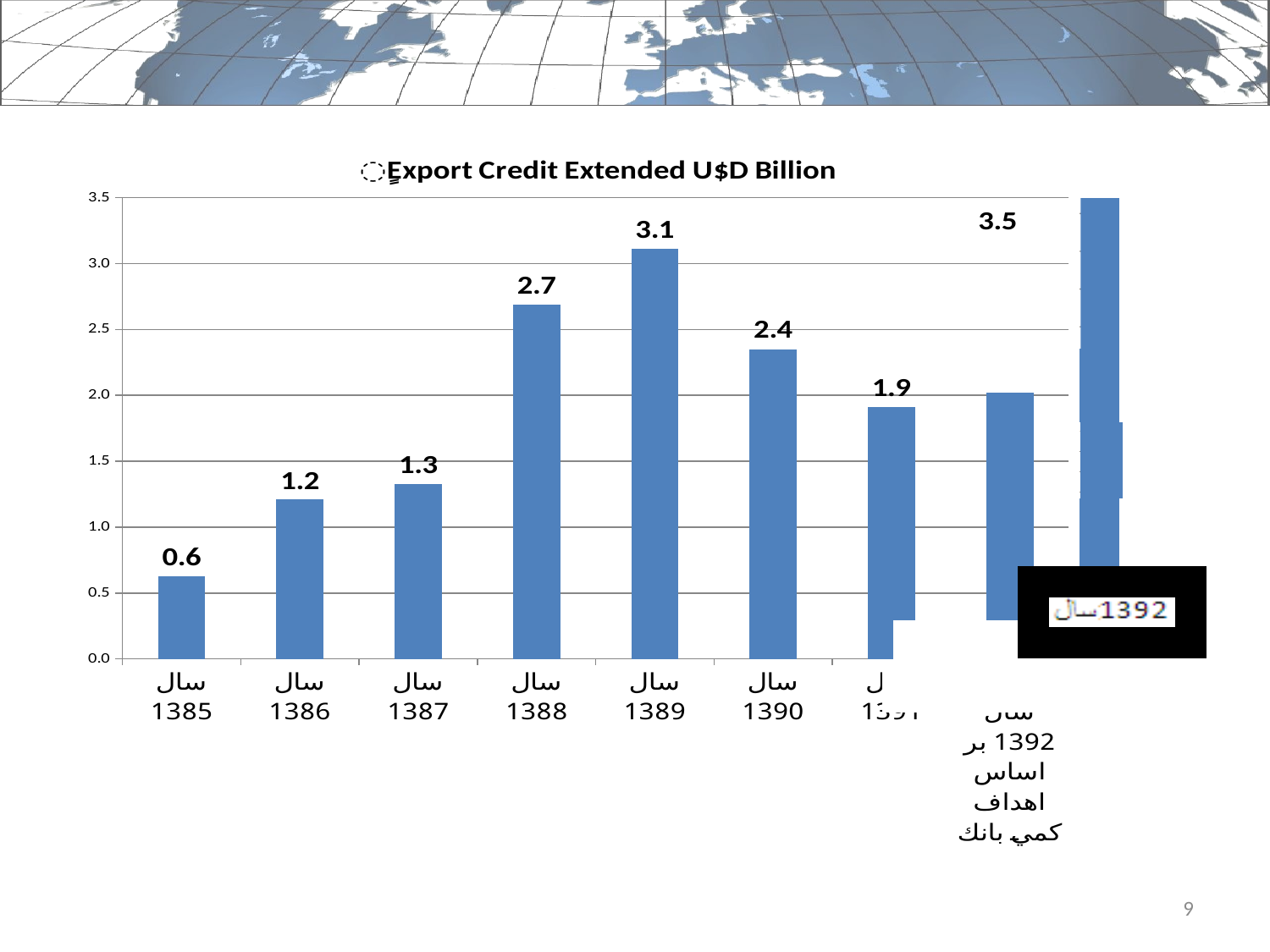
Which year has the lowest value? سال 1385 What is the value for سال 1385? 0.6 What is the value for سال 1387? 1.3 Do the values rise or fall from سال 1385 to سال 1389? rise Which is larger, the value for سال 1388 or the value for سال 1390? سال 1388 Is the value for سال 1386 greater or less than 1.5? less What is the difference between the values for سال 1389 and سال 1388? 0.4 What is the title of the chart? Export Credit Extended U$D Billion What is the value for سال 1389? 3.1 What is the value for سال 1388? 2.7 What kind of chart is shown on the slide? bar chart What is the value for سال 1390? 2.4